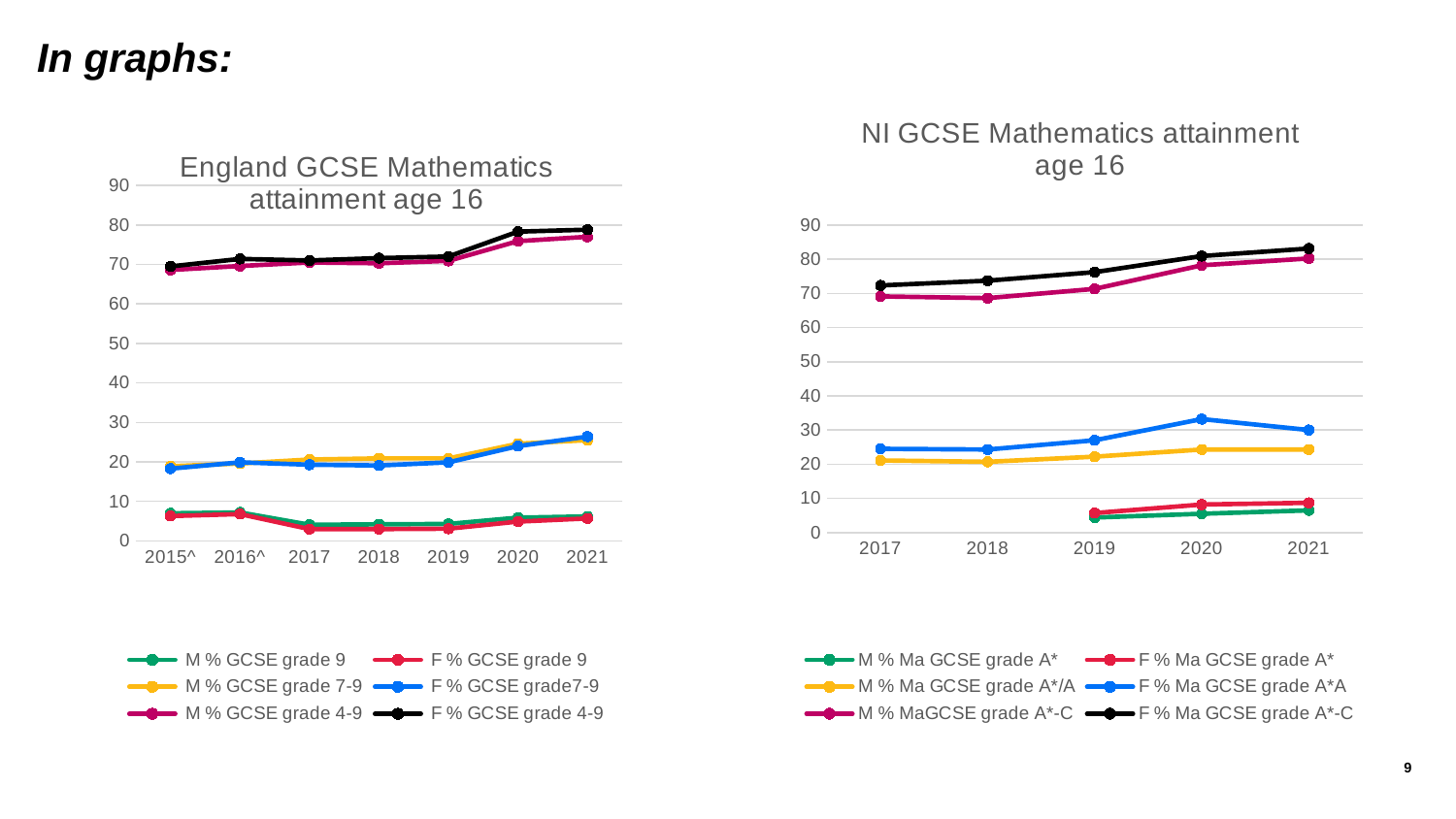
In the England GCSE Mathematics attainment age 16 chart, is the value for F % GCSE grade 4-9 in 2015^ greater or less than 60? greater In the England GCSE Mathematics attainment age 16 chart, is the value for M % GCSE grade 9 in 2018 greater or less than 10? less In the England GCSE Mathematics attainment age 16 chart, is the value for M % GCSE grade 9 larger in 2015^ or in 2017? 2015^ What kind of chart is the England GCSE Mathematics attainment age 16 chart? line chart In the NI GCSE Mathematics attainment age 16 chart, is the value for F % Ma GCSE grade A*-C in 2021 greater or less than 80? greater In the England GCSE Mathematics attainment age 16 chart, what colour is the F % GCSE grade 4-9 line? black How many years are shown on the x axis of the NI GCSE Mathematics attainment age 16 chart? 5 In the NI GCSE Mathematics attainment age 16 chart, which is larger in 2020: F % Ma GCSE grade A*A or M % Ma GCSE grade A*/A? F % Ma GCSE grade A*A How many years are shown on the x axis of the England GCSE Mathematics attainment age 16 chart? 7 In the NI GCSE Mathematics attainment age 16 chart, does the F % Ma GCSE grade A*-C line rise or fall from 2017 to 2021? rise How many series does the legend of the NI GCSE Mathematics attainment age 16 chart list? 6